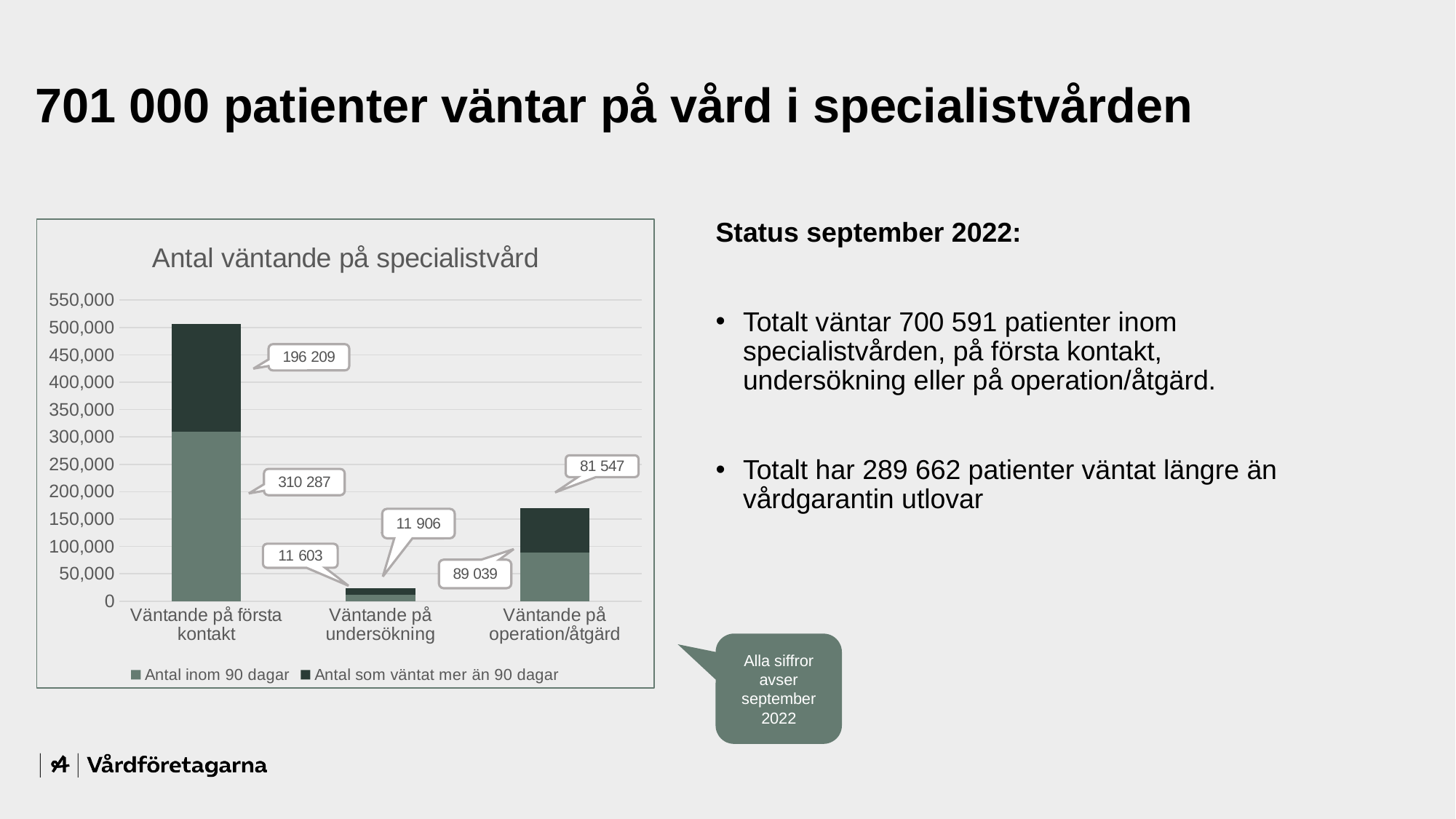
What is the value of 'Antal som väntat mer än 90 dagar' for 'Väntande på operation/åtgärd'? 81 547 How many series does the chart legend list? 2 Which category has the highest total number of waiting patients? Väntande på första kontakt What is the value of 'Antal som väntat mer än 90 dagar' for 'Väntande på undersökning'? 11 906 Which category has the lowest total number of waiting patients? Väntande på undersökning What type of chart is shown on the slide? Stacked bar chart What is the total of the stacked bar for 'Väntande på operation/åtgärd'? 170 586 What is the difference between 'Antal inom 90 dagar' and 'Antal som väntat mer än 90 dagar' for 'Väntande på första kontakt'? 114 078 What is the title of the chart? Antal väntande på specialistvård What is the value of 'Antal inom 90 dagar' for 'Väntande på första kontakt'? 310 287 How many categories are shown on the x axis of the chart? 3 For 'Väntande på operation/åtgärd', which is larger: 'Antal inom 90 dagar' or 'Antal som väntat mer än 90 dagar'? Antal inom 90 dagar